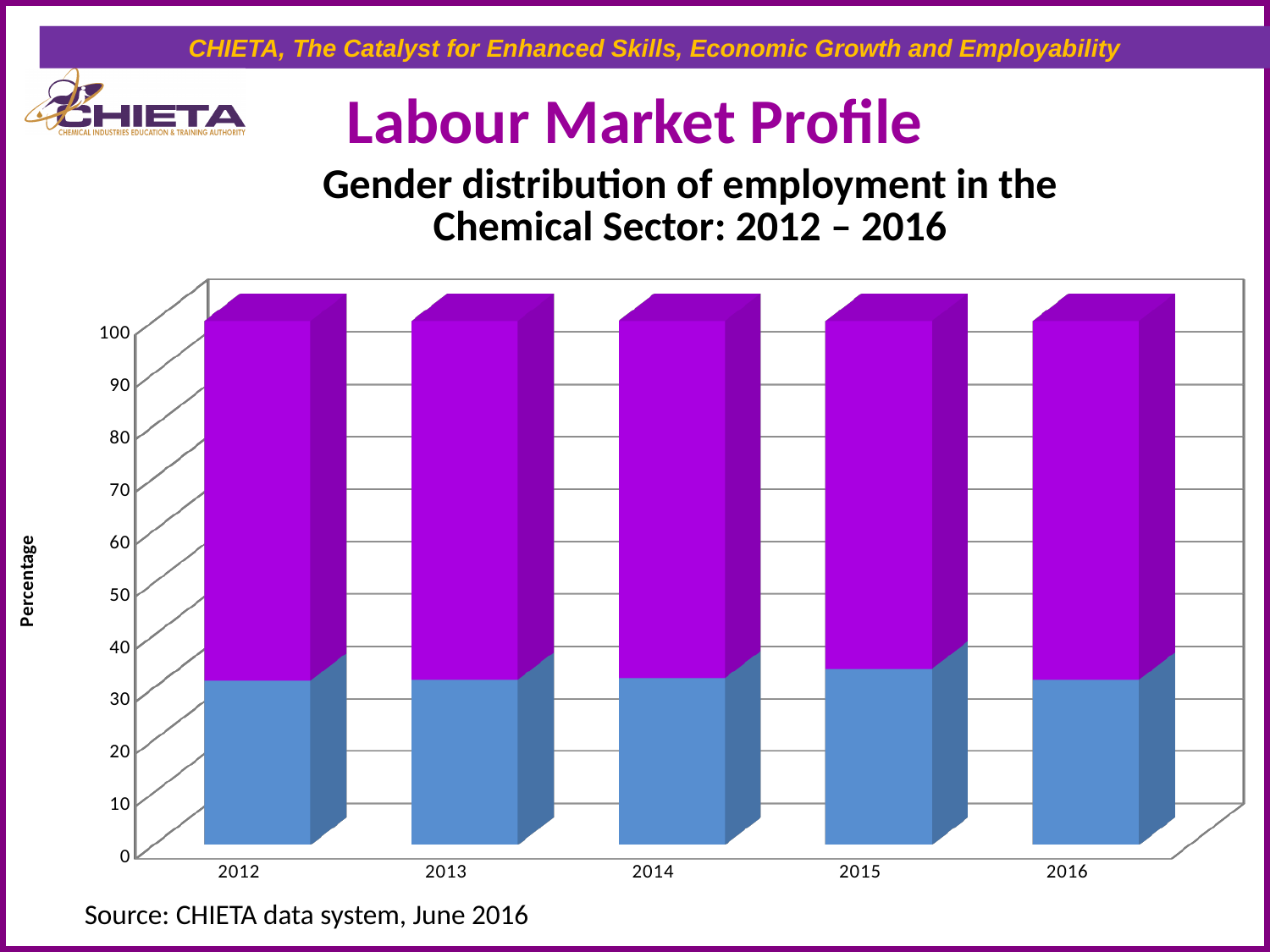
Is the value of the blue (bottom) segment for 2012 greater or less than 40? less Is the total height of the stacked bar for 2013 greater or less than 90? greater Is the value of the blue (bottom) segment for 2016 greater or less than 50? less Which years are shown on the x axis of the chart? 2012, 2013, 2014, 2015, 2016 What is the title of the chart? Gender distribution of employment in the Chemical Sector: 2012 – 2016 Is the purple (top) segment for 2012 larger or smaller than the blue (bottom) segment for 2012? larger How many stacked segments make up each bar in the chart? 2 What kind of chart is shown on the slide? Stacked bar chart How many years are shown along the x axis of the chart? 5 What is the label on the vertical axis of the chart? Percentage